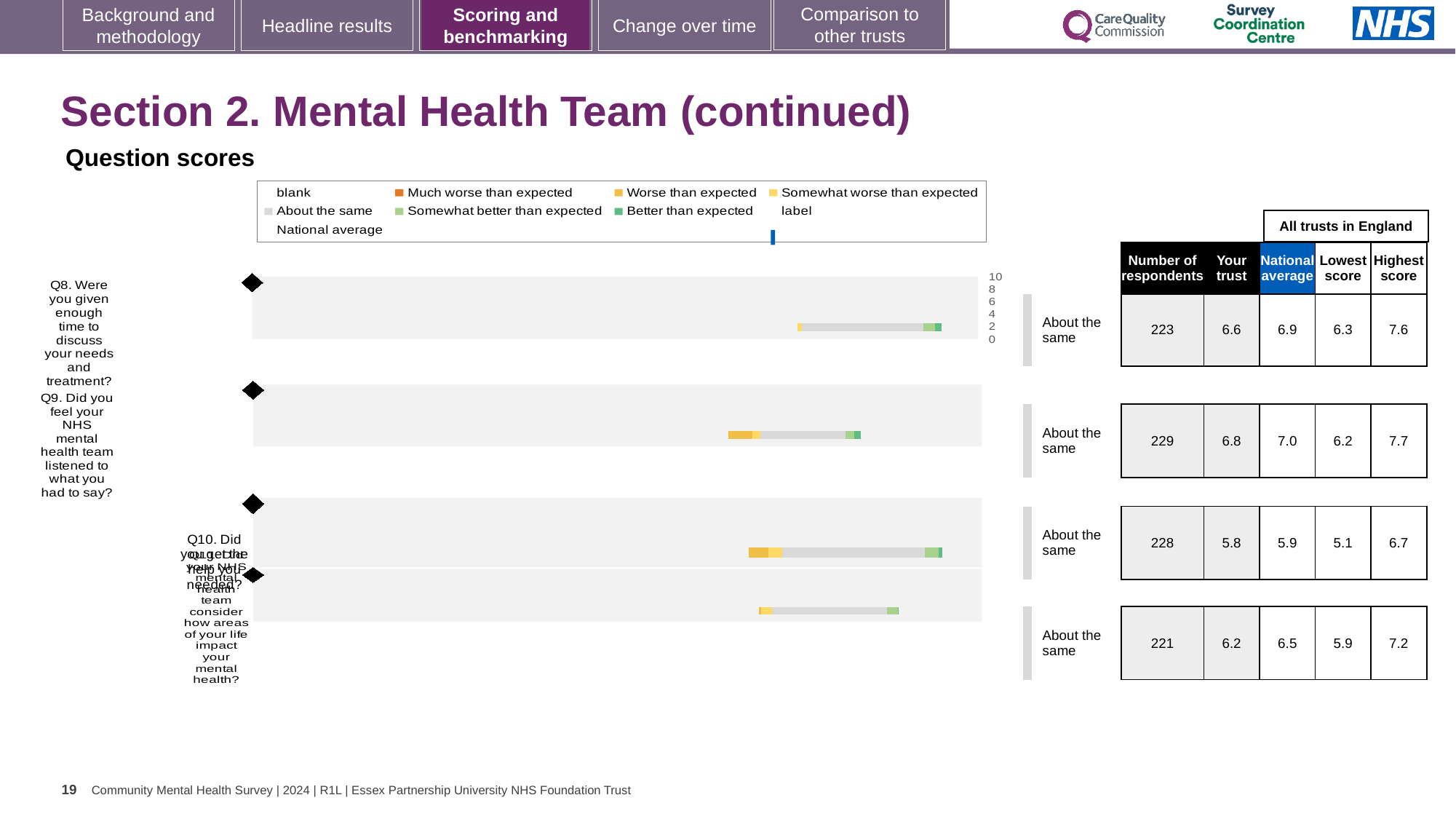
How many question rows (bars) are plotted in the question scores chart? 4 Which question has the highest 'Your trust' score in the table? Q9 Which question has the lowest 'Your trust' score in the table? Q10 In the table beside the chart, what is the 'Your trust' score for Q9? 6.8 What is the heading above the chart? Question scores What colour does the legend use for 'Better than expected'? green For Q8, which is larger: the 'Your trust' score or the national average? National average In the table beside the chart, what is the highest score for Q9? 7.7 In the table beside the chart, what is the national average for Q10? 5.9 In the table beside the chart, how many respondents are listed for Q8? 223 For Q8, what is the difference between the national average and the 'Your trust' score? 0.3 What kind of chart is used to show the question scores on this slide? bar chart